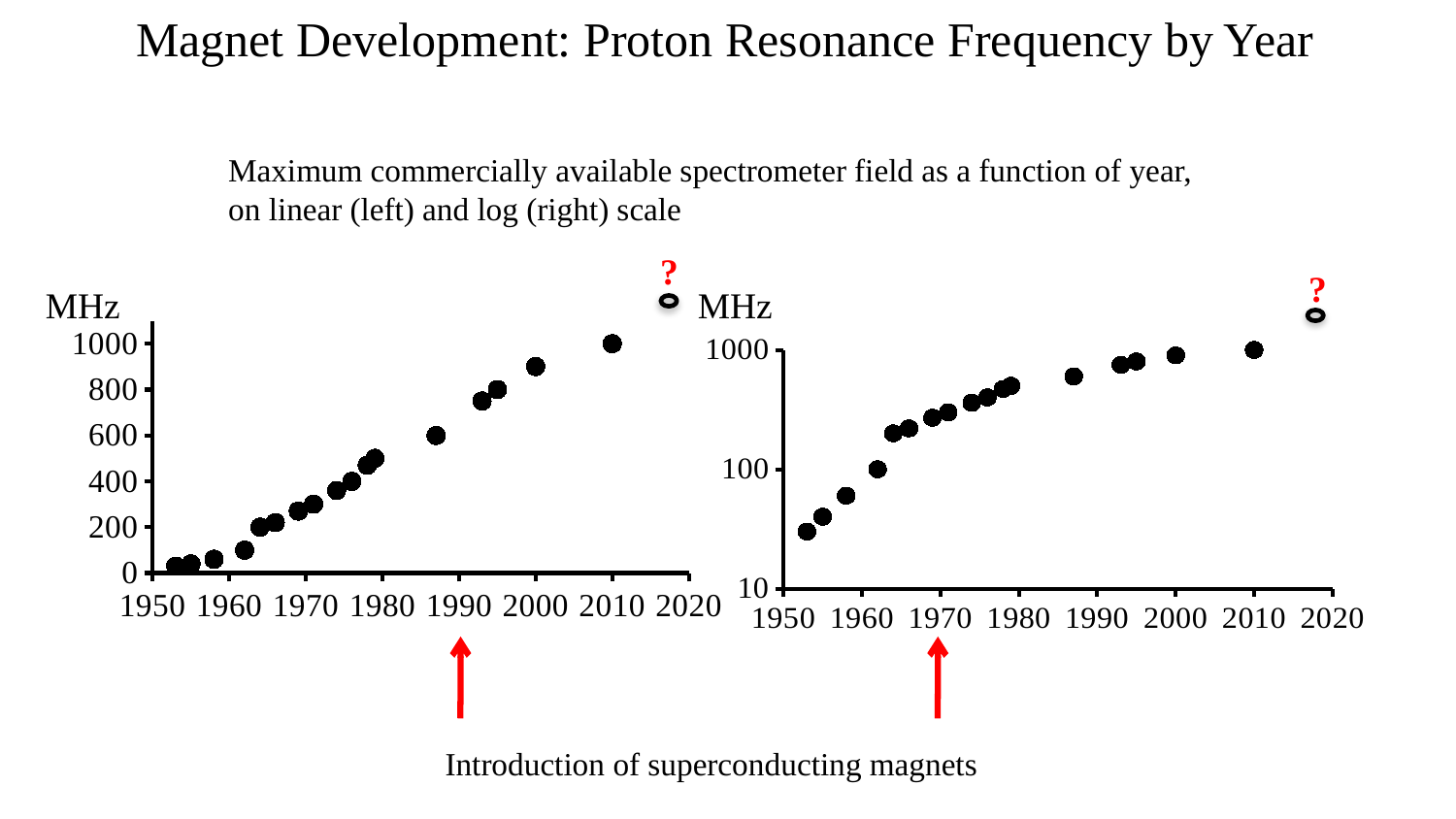
On the left (linear scale) chart, is the value for the point at 1965 greater or less than 400? less What event do the red arrows below the charts mark? Introduction of superconducting magnets On the right (log scale) chart, is the value for the point at 1990 greater or less than 100? greater What kind of chart is the left chart on the slide? scatter chart On the left (linear scale) chart, excluding the open circle marked '?', which year has the highest plotted value? 2010 On the left (linear scale) chart, do the values rise or fall as the year increases? rise What unit is shown on the y axis of both charts? MHz On the left (linear scale) chart, what is the value for the point at 2010? 1000 On the left (linear scale) chart, is the value for the point at 1980 greater or less than 400? greater On the left (linear scale) chart, which is larger: the value at 2000 or the value at 2010? 2010